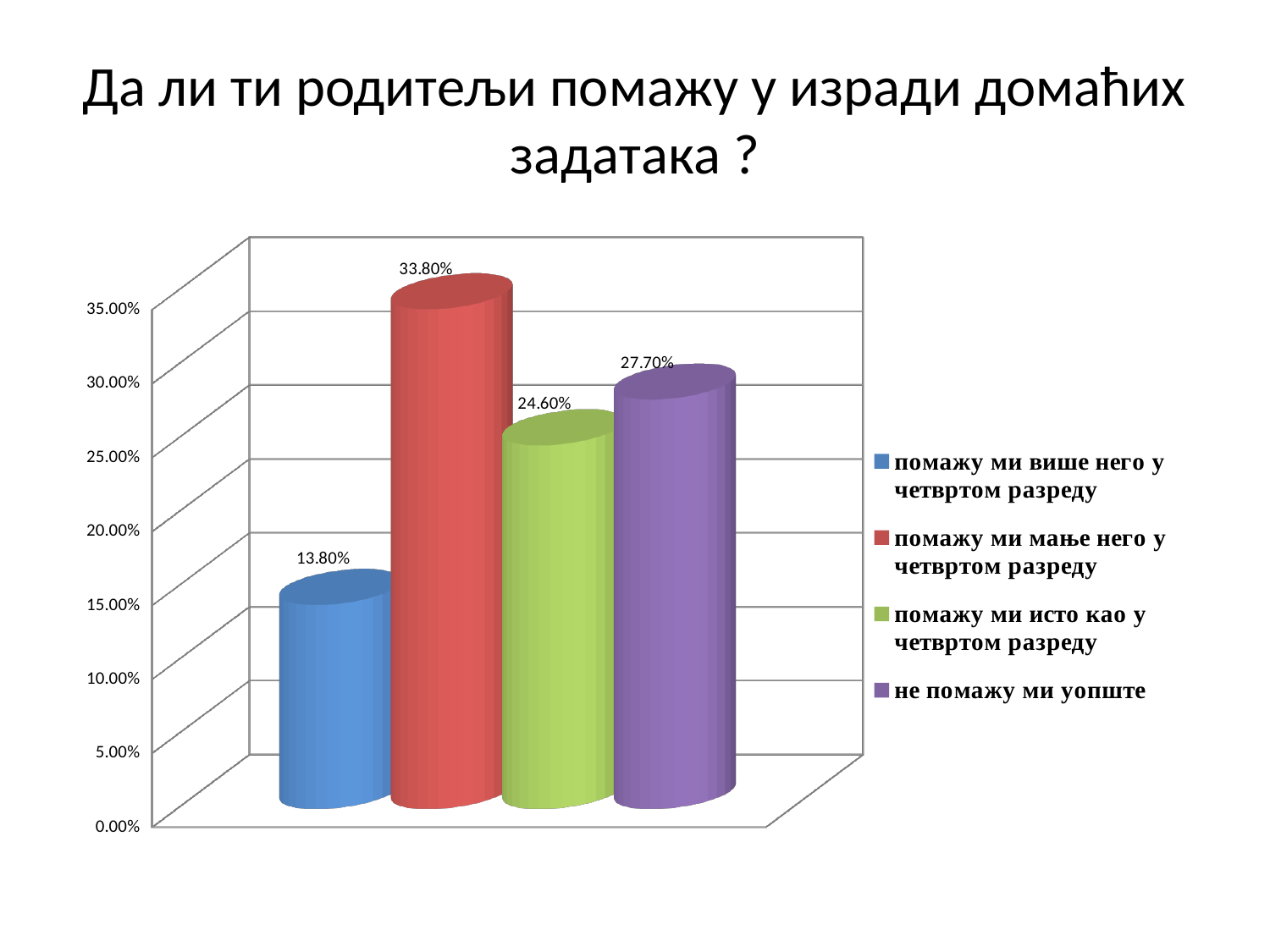
How many series does the legend list? 4 Which response has the lowest value? помажу ми више него у четвртом разреду Which response has the highest value? помажу ми мање него у четвртом разреду What colour is the bar for "не помажу ми уопште"? purple What value is shown for "помажу ми исто као у четвртом разреду"? 24.60% What value is shown for "помажу ми мање него у четвртом разреду"? 33.80% What value is shown for "не помажу ми уопште"? 27.70% What is the difference between the values for "помажу ми мање него у четвртом разреду" and "помажу ми више него у четвртом разреду"? 20.00% What value is shown for "помажу ми више него у четвртом разреду"? 13.80% Is the value for "помажу ми исто као у четвртом разреду" greater or less than 20.00%? greater Which is larger: the value for "не помажу ми уопште" or the value for "помажу ми исто као у четвртом разреду"? не помажу ми уопште What kind of chart is shown on the slide? bar chart